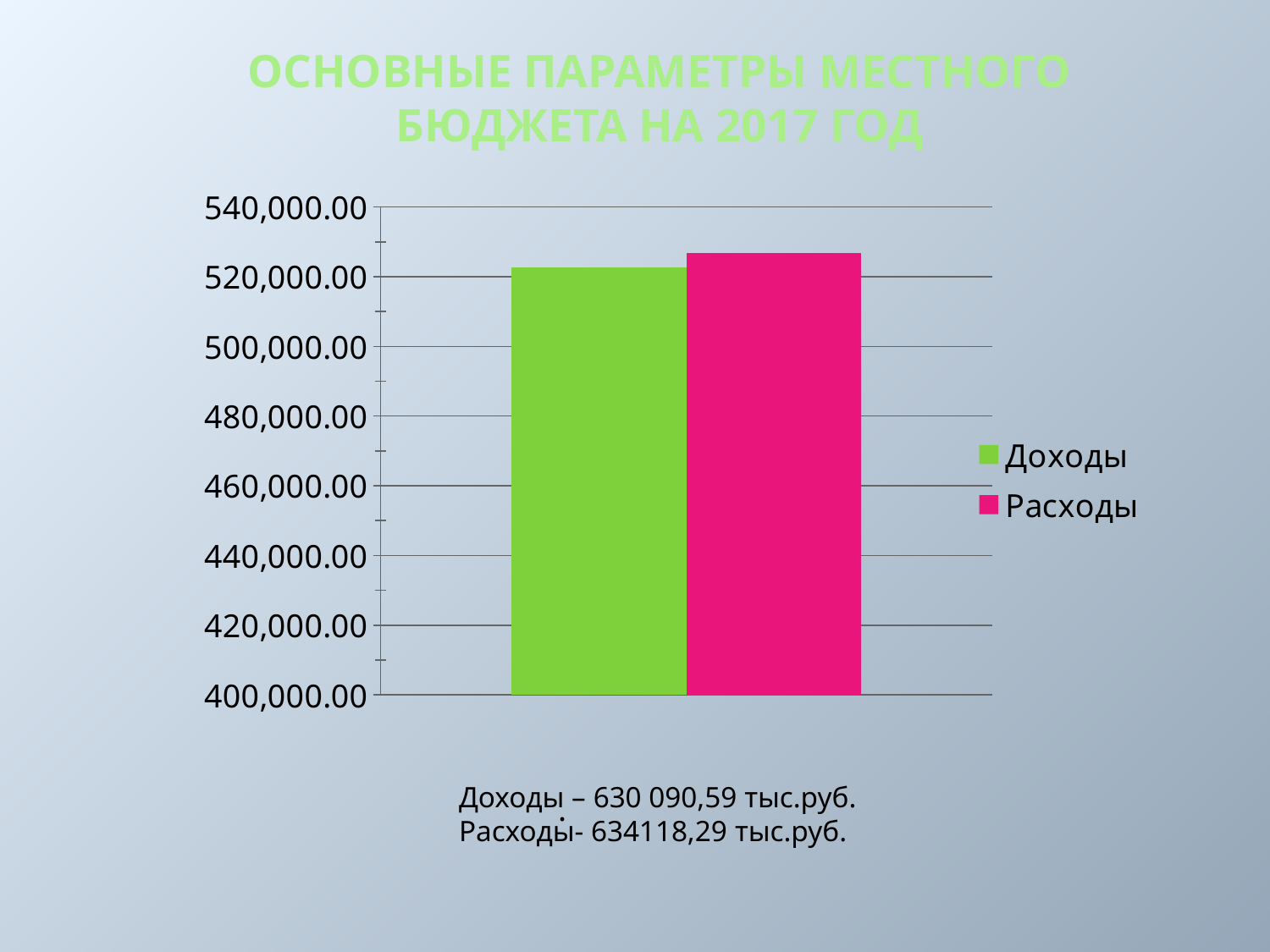
Is the value for Доходы greater or less than 500,000.00? greater What colour is the bar for Доходы in the chart? green What kind of chart is shown on the slide? bar chart Which is larger, the value for Доходы or the value for Расходы? Расходы How many bars are plotted in the chart? 2 How many series does the legend list? 2 Is the value for Доходы greater or less than 540,000.00? less Is the value for Расходы greater or less than 520,000.00? greater What is the title of the slide containing the chart? ОСНОВНЫЕ ПАРАМЕТРЫ МЕСТНОГО БЮДЖЕТА НА 2017 ГОД Which series has the taller bar, Доходы or Расходы? Расходы Which series has the shorter bar in the chart? Доходы